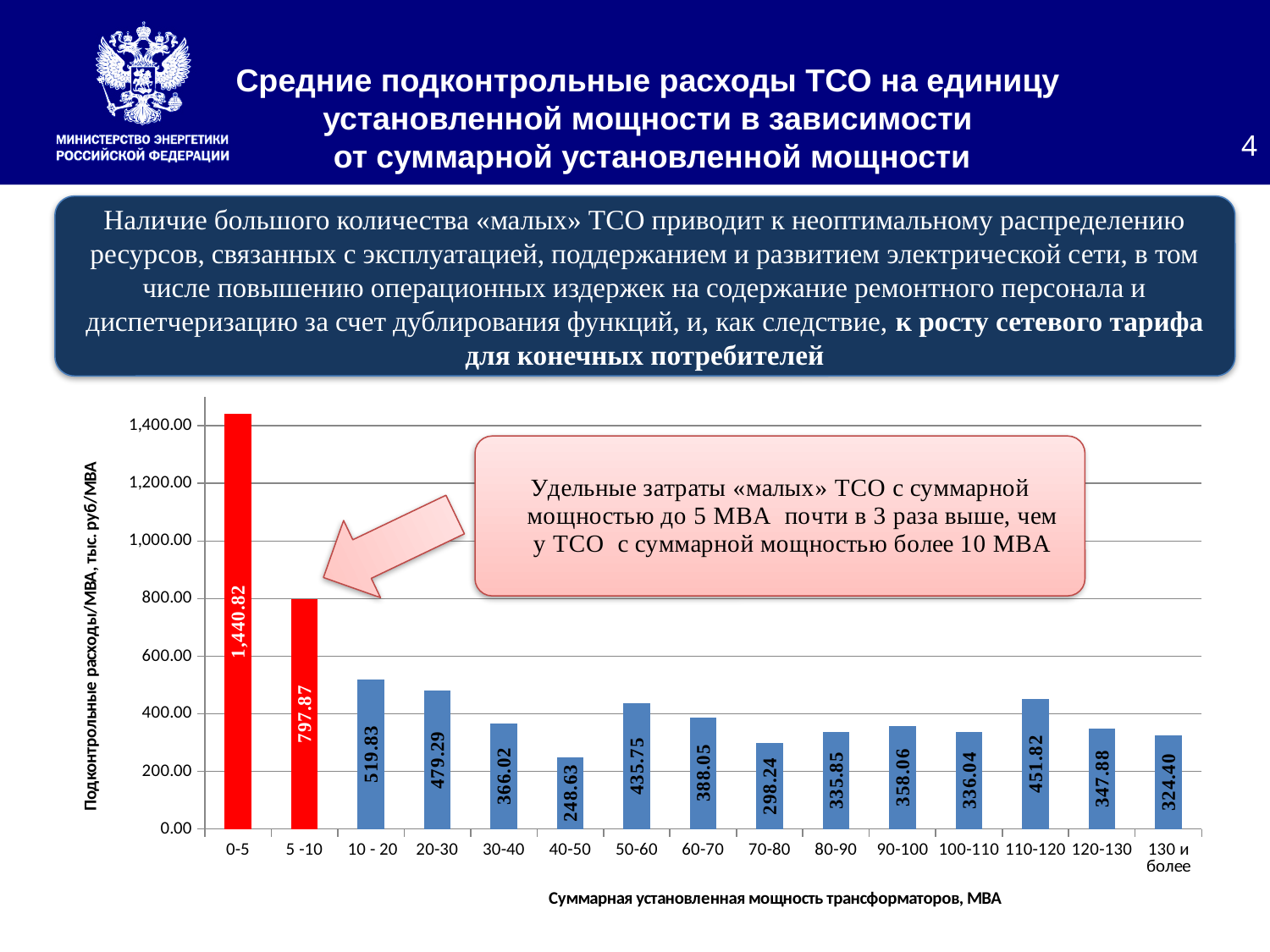
How many categories are shown on the x axis? 15 What is the difference between the values for 0-5 and 5-10? 642.95 What is the value for the 40-50 category? 248.63 What is the value for the 110-120 category? 451.82 Which category has the lowest value? 40-50 Which category has the highest value? 0-5 What is the value for the 0-5 category? 1,440.82 What colour are the bars for the 0-5 and 5-10 categories? red What kind of chart is shown on the slide? bar chart Which is larger, the value for 10-20 or the value for 20-30? 10-20 Is the value for 50-60 greater or less than 400? greater What is the value for the 5-10 category? 797.87